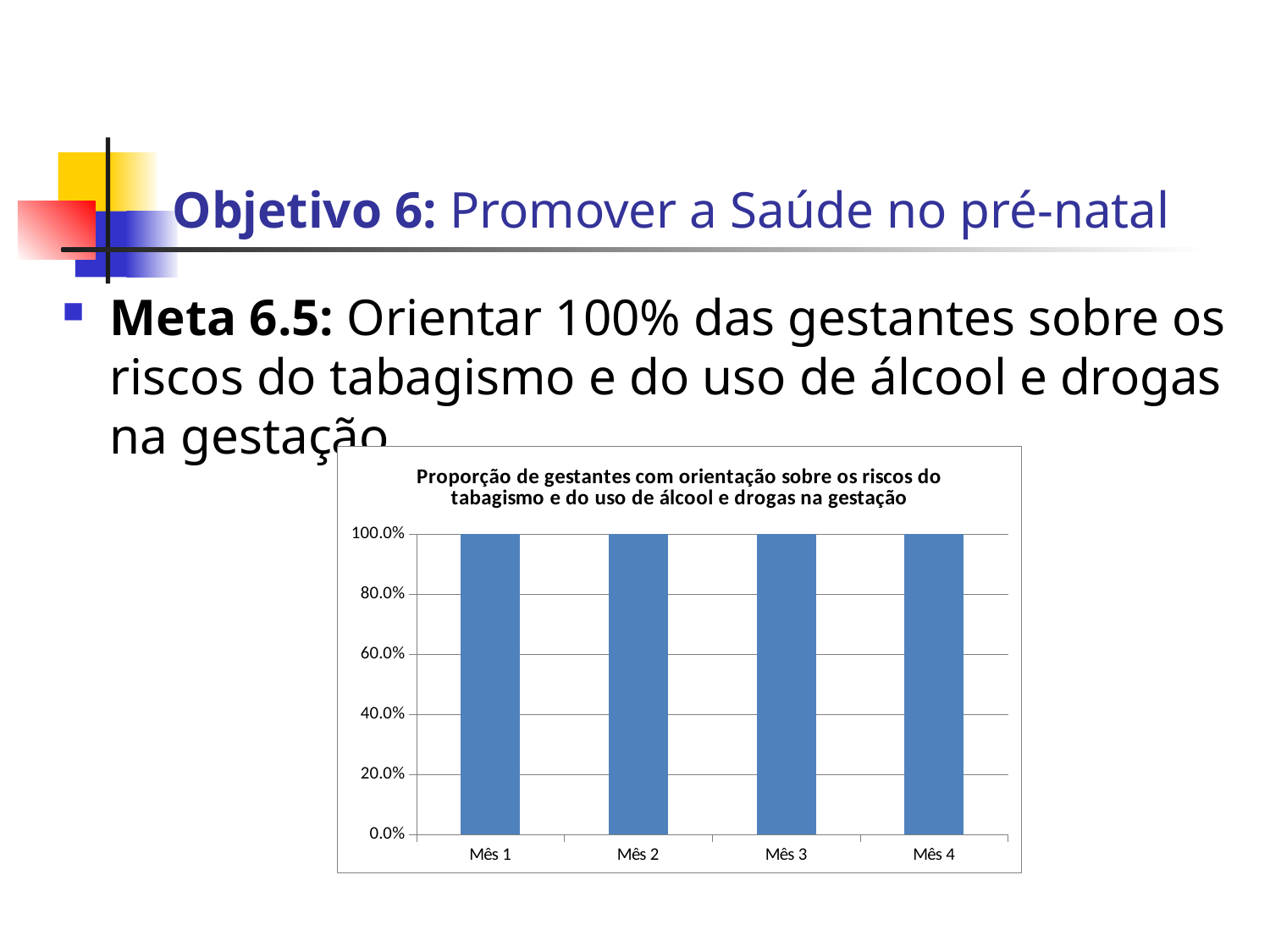
What is the title of the chart? Proporção de gestantes com orientação sobre os riscos do tabagismo e do uso de álcool e drogas na gestação What is the difference between the values for Mês 1 and Mês 2? 0.0% What is the highest value shown on the y axis of the chart? 100.0% How many categories are shown on the x axis of the chart? 4 What is the value for Mês 1 in the chart? 100.0% What colour are the bars in the chart? blue Do the values rise, fall or stay the same from Mês 1 to Mês 4? stay the same Is the value for Mês 2 greater or less than 80.0%? greater What is the value for Mês 4 in the chart? 100.0% Is the value for Mês 4 greater or less than 60.0%? greater What is the value for Mês 3 in the chart? 100.0% What kind of chart is shown on the slide? bar chart